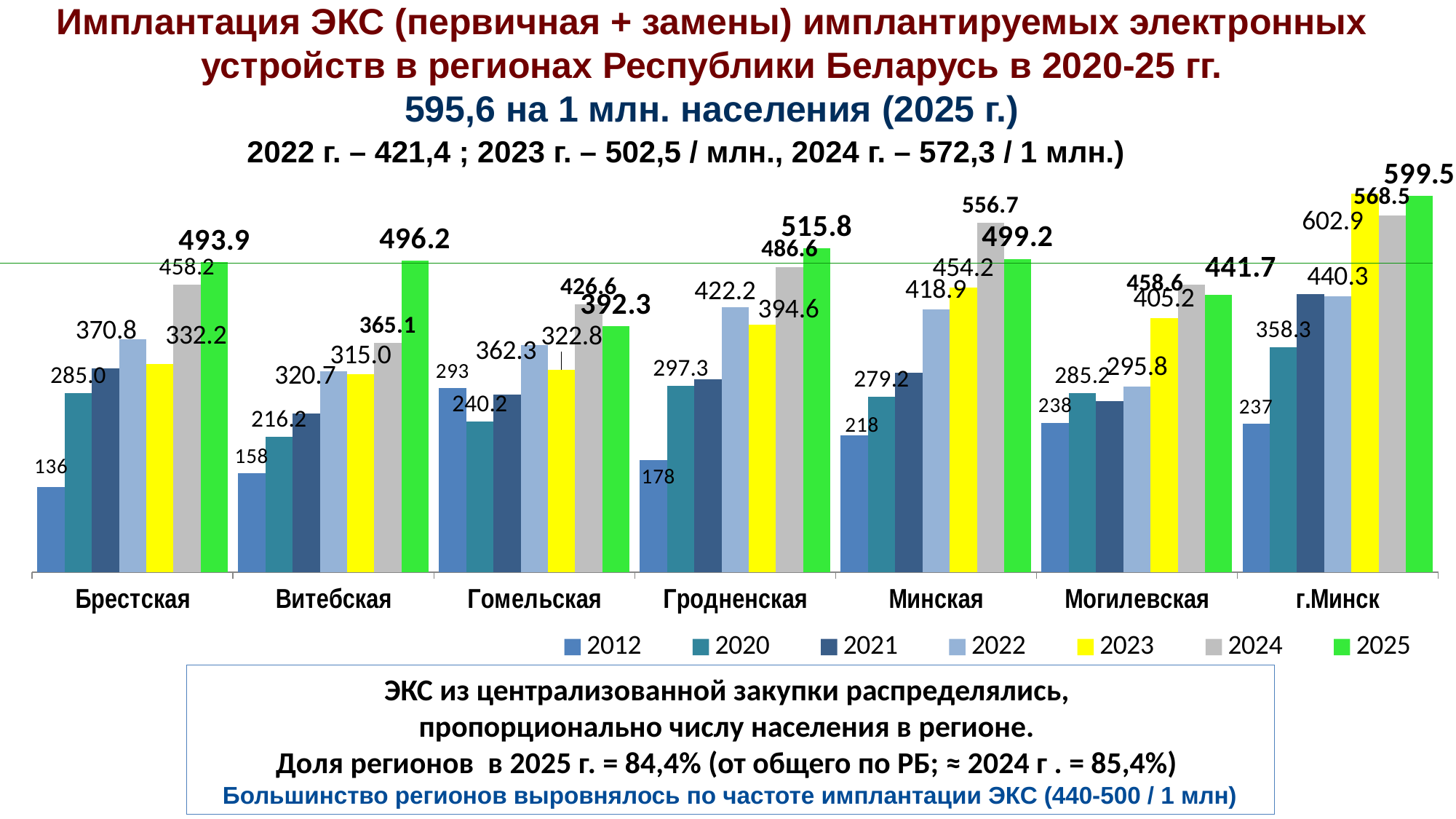
What is the difference between the 2025 values for г.Минск and Гомельская? 207.2 Which region has the lowest value in the 2025 series? Гомельская How many regions are shown on the x axis? 7 What is the value for Минская in the 2024 series? 556.7 What kind of chart is shown on the slide? bar chart Which region has the highest value in the 2025 series? г.Минск What is the value for г.Минск in the 2025 series? 599.5 How many series does the legend list? 7 In the 2025 series, which is larger: Минская or Могилевская? Минская Which colour represents the 2025 series in the legend? green What is the value for Гомельская in the 2012 series? 293 Which region has the lowest value in the 2012 series? Брестская